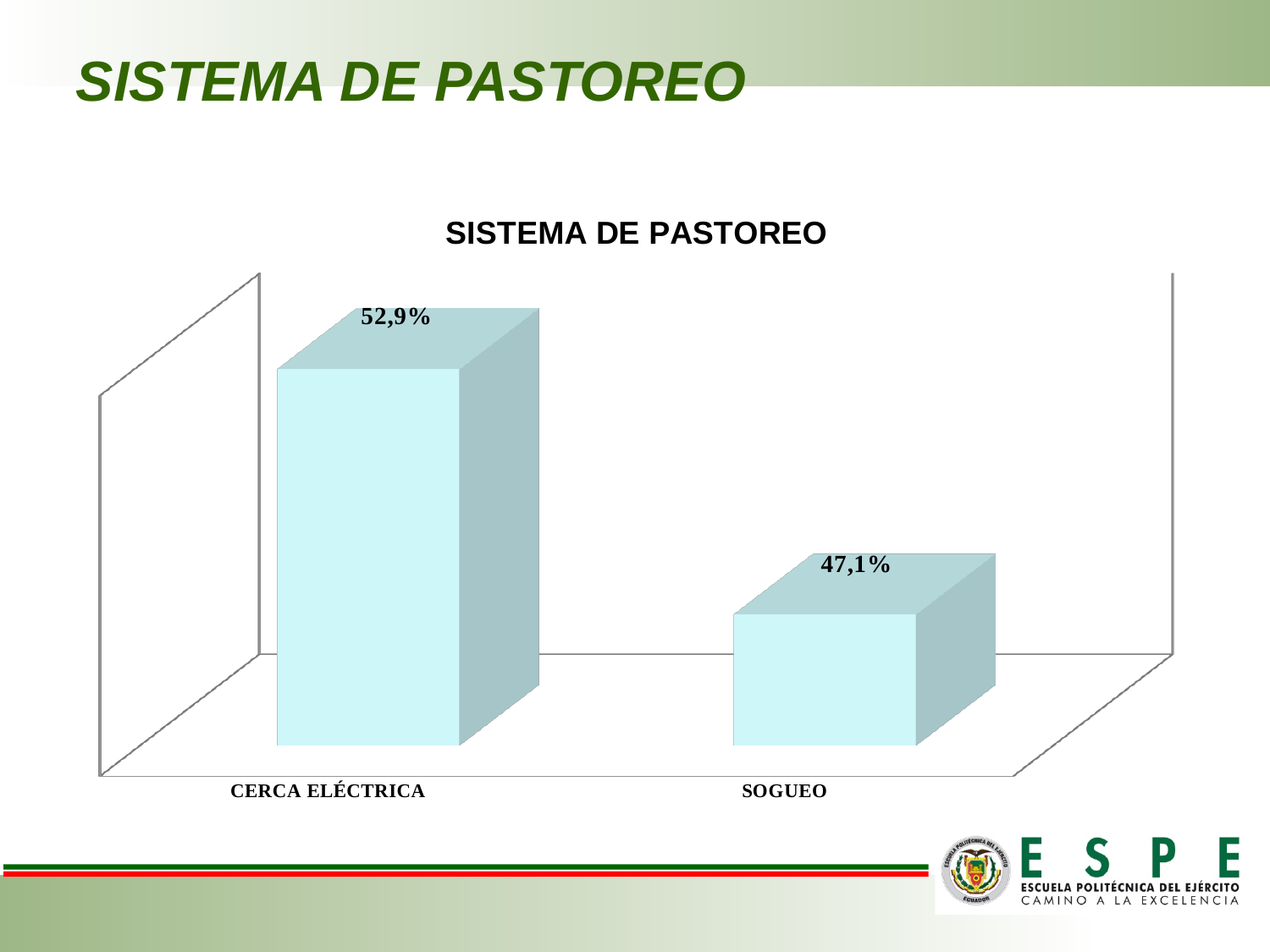
What is the total of the two values shown in the chart? 100% Which category has the highest value? CERCA ELÉCTRICA What is the value for SOGUEO? 47,1% Which category has the lowest value? SOGUEO What is the value for CERCA ELÉCTRICA? 52,9% Do the values rise or fall from left to right along the x axis? fall What is the title of the chart? SISTEMA DE PASTOREO How many categories are shown in the chart? 2 What kind of chart is shown on the slide? bar chart What is the difference between the values for CERCA ELÉCTRICA and SOGUEO? 5,8% Which is larger, the value for CERCA ELÉCTRICA or the value for SOGUEO? CERCA ELÉCTRICA